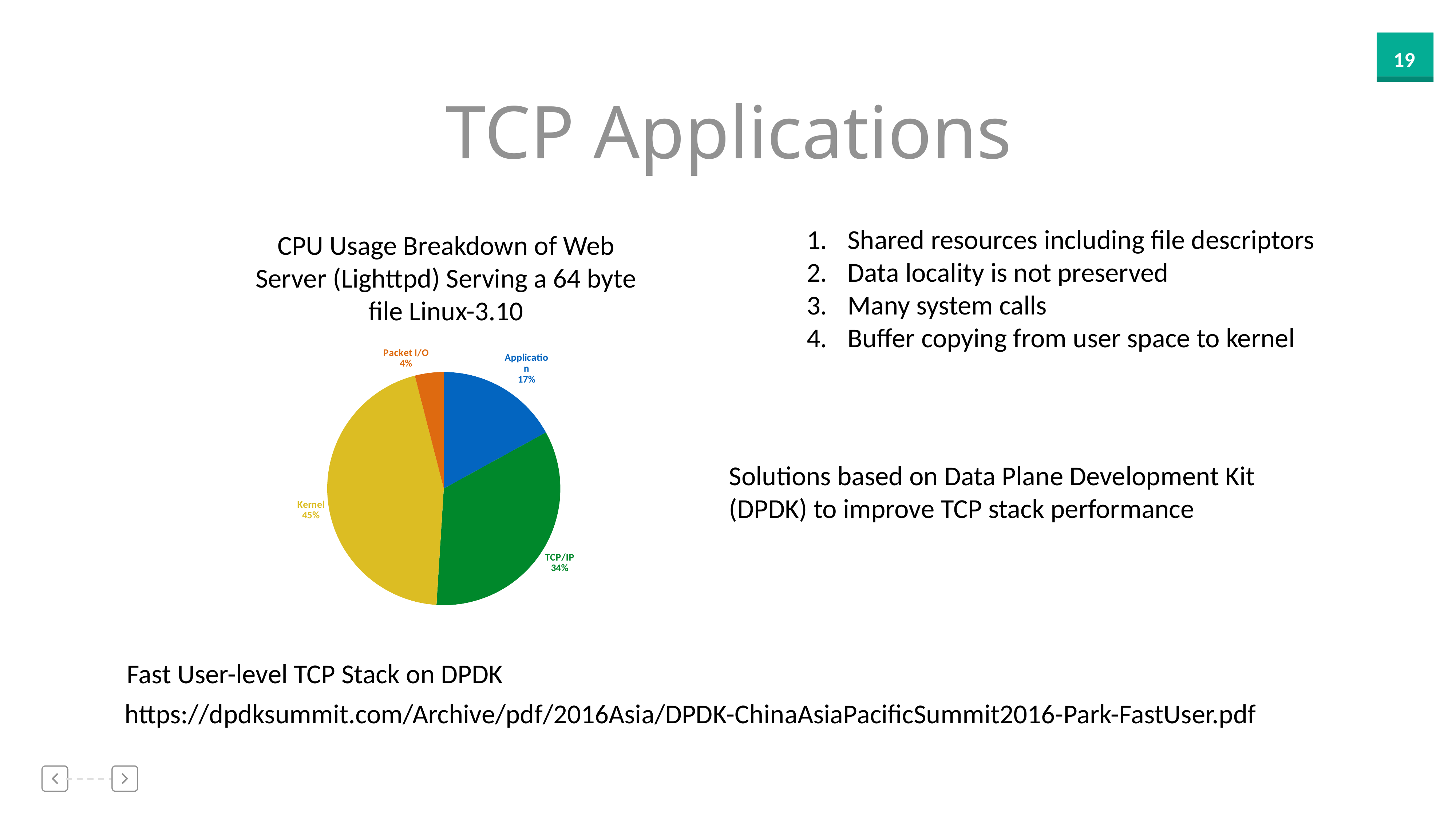
What is the difference in percentage points between the Kernel and TCP/IP slices? 11 How many slices does the pie chart have? 4 What kind of chart is shown on the slide? Pie chart Which category has the smallest share of CPU usage? Packet I/O What percentage is shown for the TCP/IP slice? 34% What percentage is shown for the Application slice? 17% What share of CPU usage does the Kernel slice represent in the pie chart? 45% What is the title of the chart? CPU Usage Breakdown of Web Server (Lighttpd) Serving a 64 byte file Linux-3.10 What colour is the Kernel slice in the pie chart? Yellow Which category has the largest share of CPU usage? Kernel Which is larger, the Application slice or the TCP/IP slice? TCP/IP What percentage is shown for the Packet I/O slice? 4%